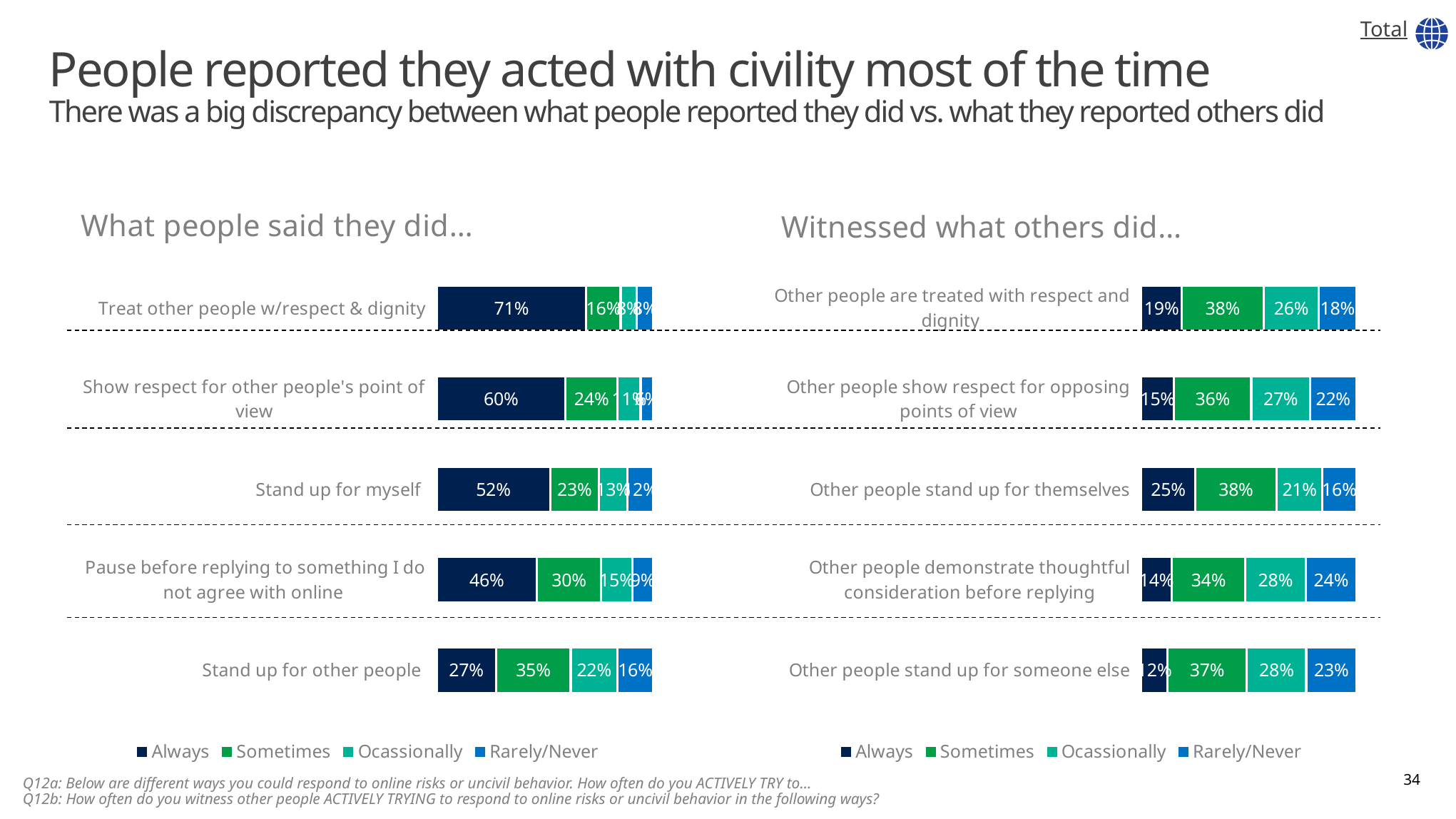
How many categories are shown in the 'Witnessed what others did…' chart? 5 In the 'Witnessed what others did…' chart, what is the Sometimes value for 'Other people stand up for someone else'? 37% In the 'What people said they did…' chart, what is the difference between the Always values for 'Show respect for other people's point of view' and 'Stand up for other people'? 33% In the 'Witnessed what others did…' chart, which is larger: the Occasionally value for 'Other people are treated with respect and dignity' or the Occasionally value for 'Other people stand up for themselves'? Other people are treated with respect and dignity In the 'Witnessed what others did…' chart, what is the Rarely/Never value for 'Other people demonstrate thoughtful consideration before replying'? 24% In the 'What people said they did…' chart, which category has the highest Always value? Treat other people w/respect & dignity In the 'Witnessed what others did…' chart, what is the difference between the Sometimes and Always values for 'Other people show respect for opposing points of view'? 21% How many series does the legend of the 'What people said they did…' chart list? 4 In the 'Witnessed what others did…' chart, which category has the lowest Always value? Other people stand up for someone else What kind of chart is the 'What people said they did…' chart? Stacked bar chart In the 'What people said they did…' chart, what is the Always value for 'Stand up for myself'? 52% In the 'What people said they did…' chart, what is the Sometimes value for 'Stand up for other people'? 35%